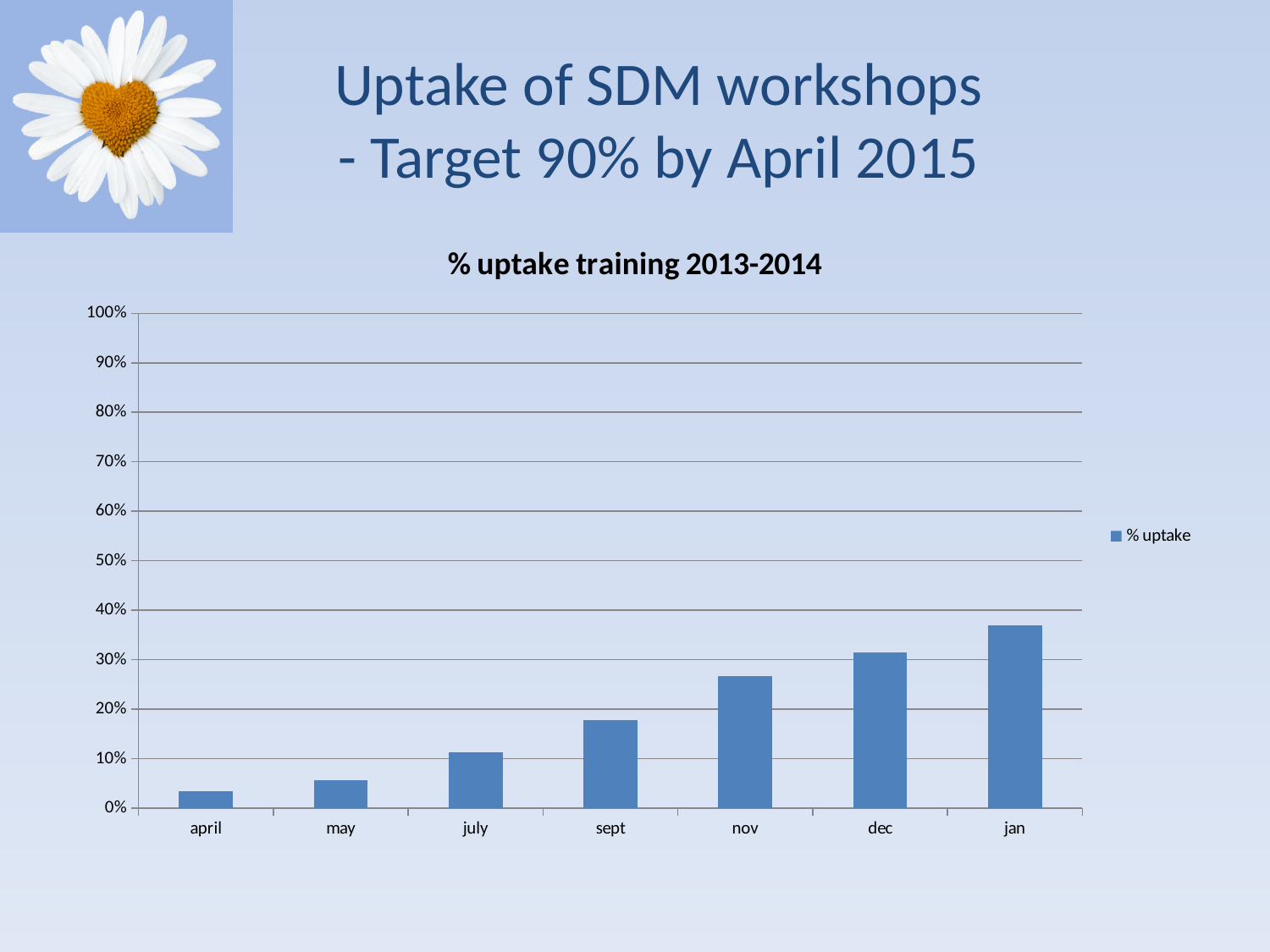
What type of chart is shown on the slide? bar chart What is the name of the series shown in the legend? % uptake Is the value for jan greater or less than 30%? greater Which month has the highest % uptake? jan Is the value for nov greater or less than 20%? greater How many series does the legend list? 1 Is the value for april greater or less than 10%? less Do the % uptake values rise or fall from april to jan? rise Which is larger, the % uptake for sept or for dec? dec Which month has the lowest % uptake? april What is the title of the chart? % uptake training 2013-2014 How many months are shown on the x axis of the chart? 7